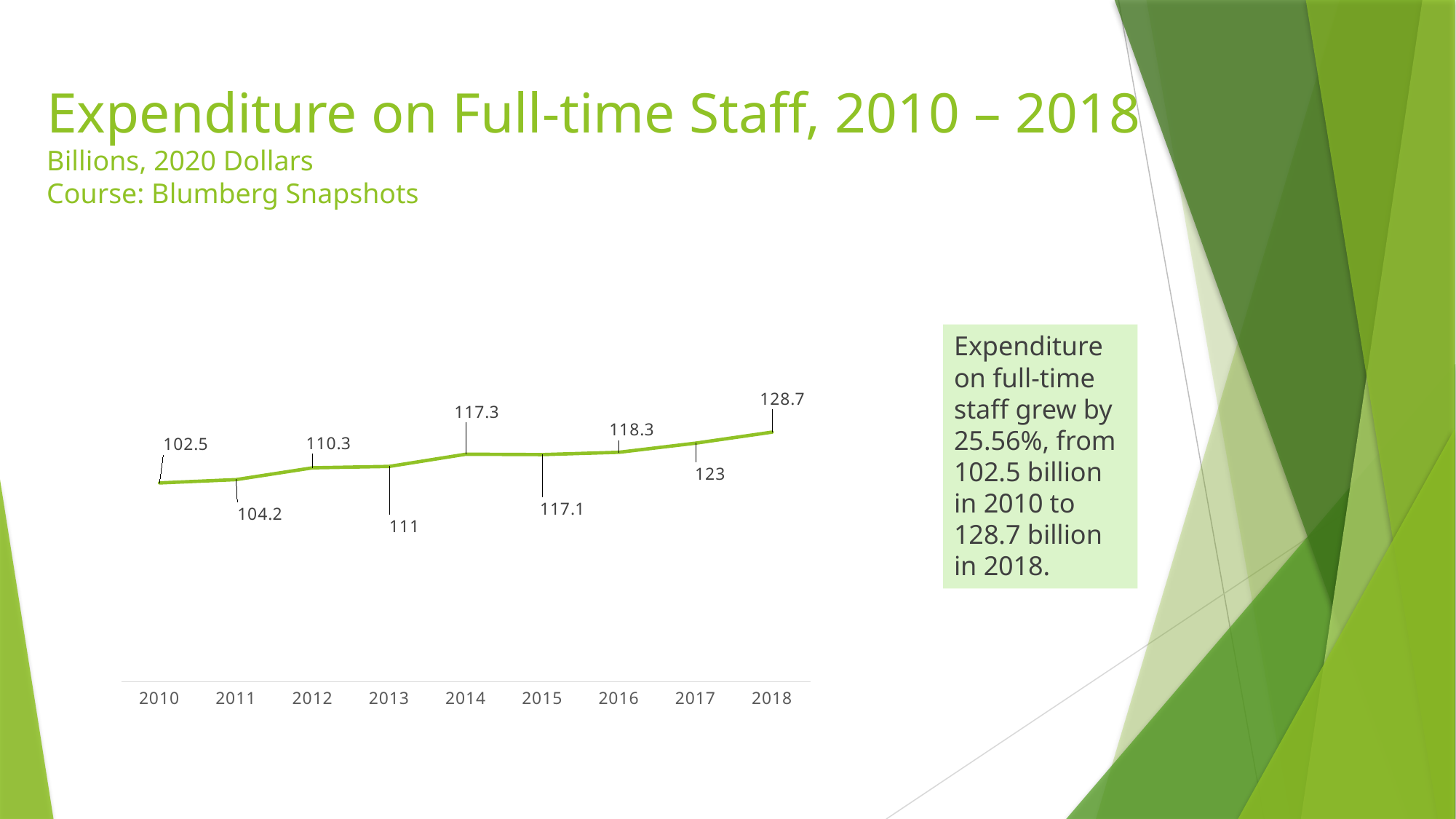
Which year has the lowest expenditure on full-time staff? 2010 What is the expenditure on full-time staff in 2014? 117.3 What is the expenditure on full-time staff in 2010? 102.5 What is the expenditure on full-time staff in 2013? 111 What is the difference between the expenditure in 2012 and in 2011? 6.1 What is the difference between the expenditure in 2018 and in 2010? 26.2 What kind of chart is shown on the slide? Line chart Which year has the larger expenditure, 2014 or 2015? 2014 Which year has the highest expenditure on full-time staff? 2018 What is the expenditure on full-time staff in 2017? 123 How many years are plotted on the chart? 9 Does expenditure on full-time staff generally rise or fall from 2010 to 2018? Rise